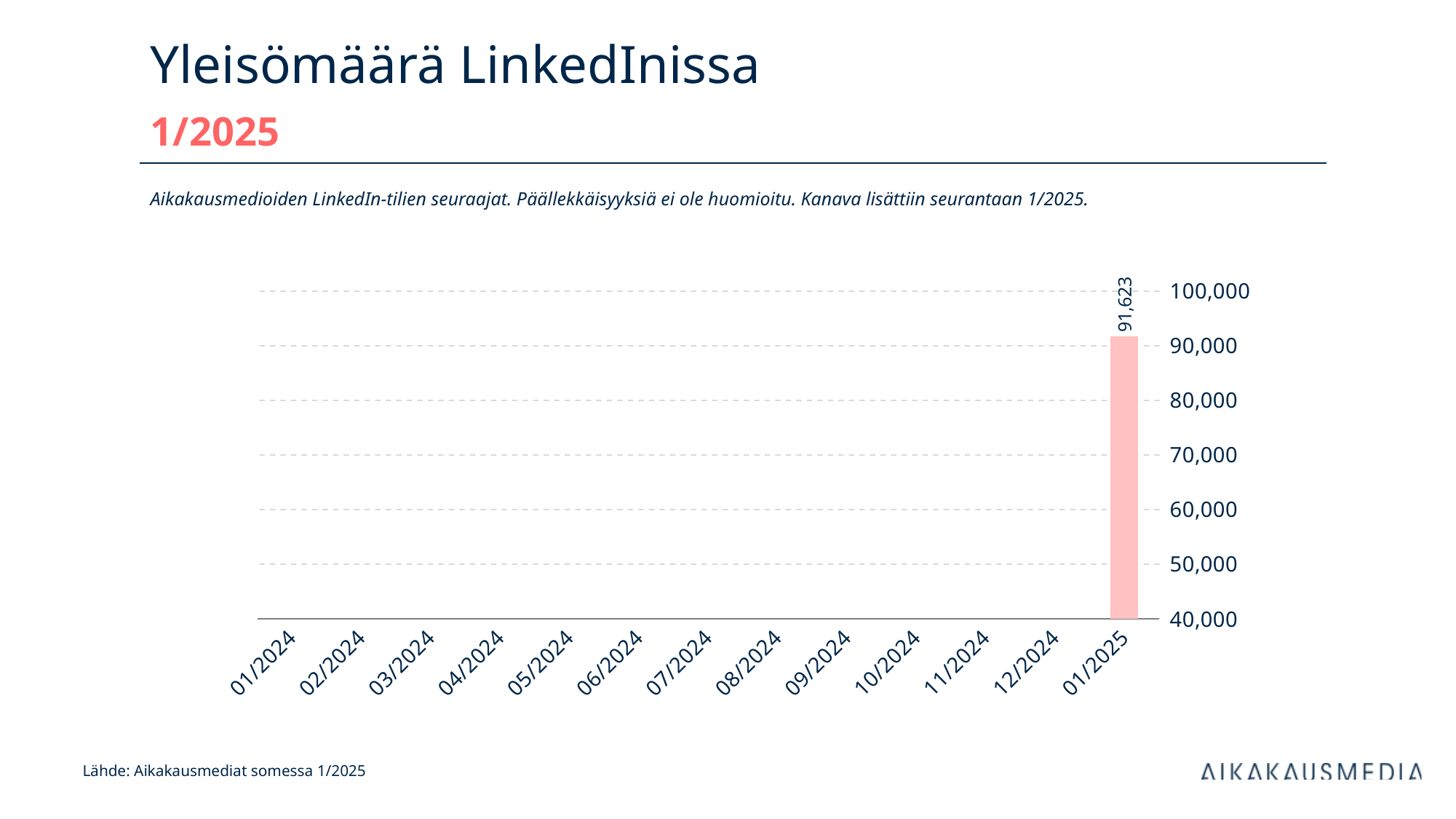
How many categories are shown on the x axis? 13 What is the title of the chart? Yleisömäärä LinkedInissa What kind of chart is shown on the slide? bar chart What is the highest value shown on the y axis? 100,000 Which category has the highest value? 01/2025 What is the first category on the x axis? 01/2024 What is the lowest value shown on the y axis? 40,000 Is the value for 01/2025 greater or less than 90,000? greater Is the value for 01/2025 greater or less than 100,000? less How many bars have a visible value in the chart? 1 What is the value for 01/2025? 91,623